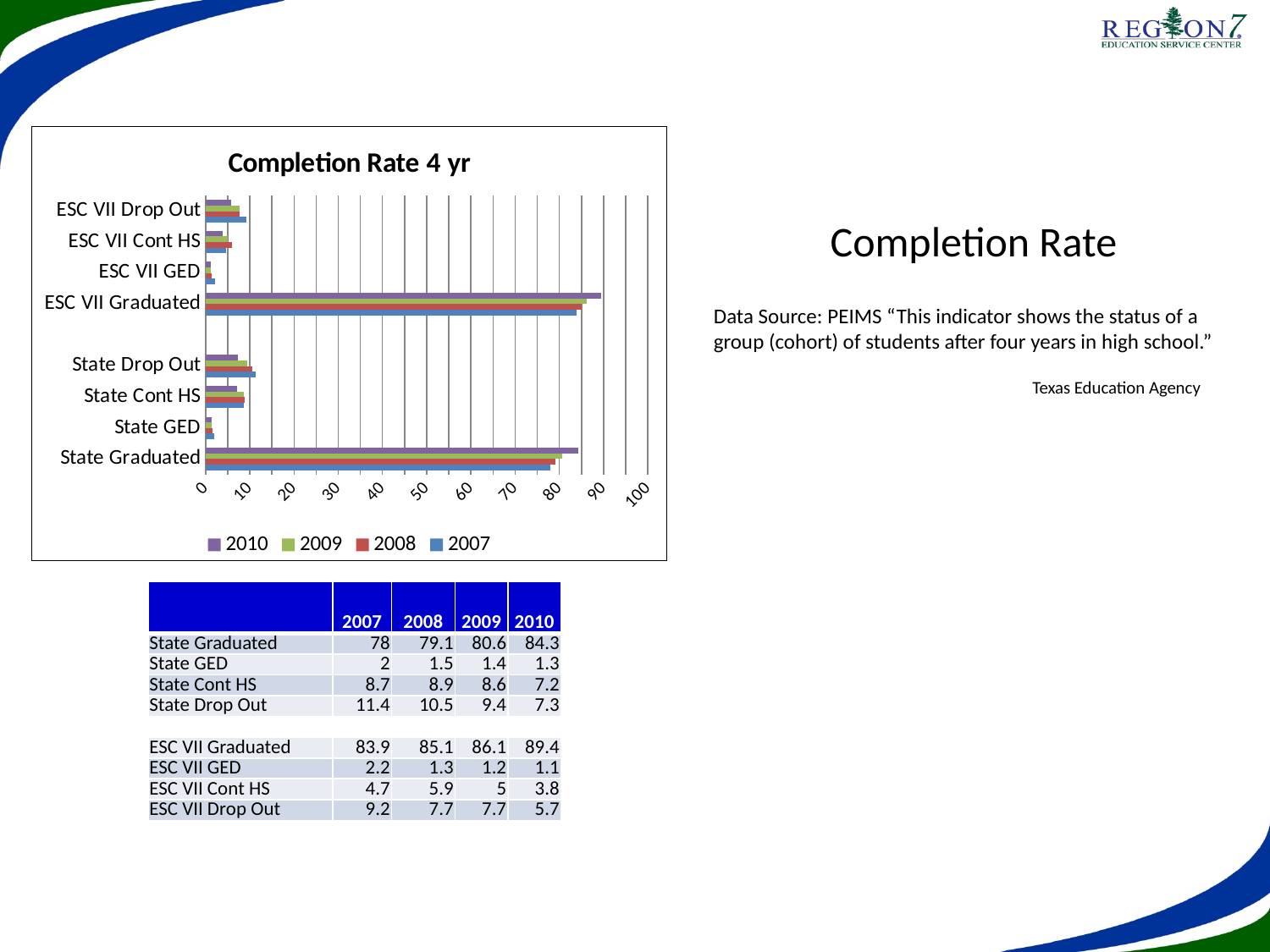
What is the value for State Drop Out in 2007? 11.4 Do the values for ESC VII Graduated rise or fall from 2007 to 2010? rise Is the value for State Graduated in 2007 greater or less than 70? greater Which is larger in 2008: State Drop Out or ESC VII Drop Out? State Drop Out Which colour represents the 2009 series in the "Completion Rate 4 yr" chart? green How many categories are plotted on the y axis of the "Completion Rate 4 yr" chart? 8 What is the difference between ESC VII Graduated and State Graduated in 2010? 5.1 What is the value for ESC VII Graduated in 2010? 89.4 Which category has the lowest value in the 2009 series? ESC VII GED How many series does the legend of the "Completion Rate 4 yr" chart list? 4 Which category has the highest value in the 2010 series? ESC VII Graduated What type of chart is shown under the title "Completion Rate 4 yr"? bar chart